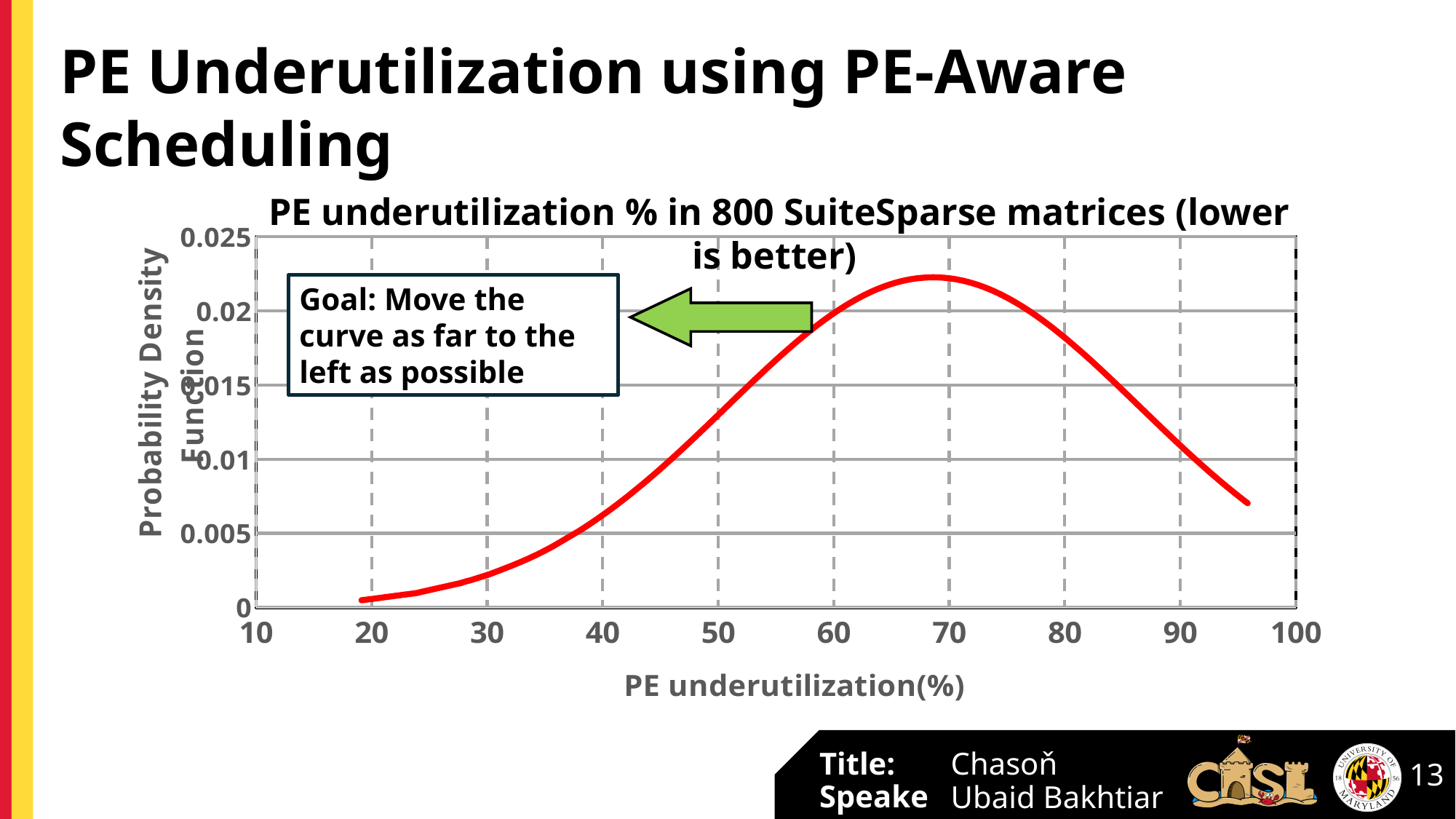
Between which two x-axis ticks does the curve reach its maximum? 60 and 70 Does the curve rise or fall between a PE underutilization of 70% and 90%? fall Is the value of the curve at a PE underutilization of 90% greater or less than 0.015? less Is the peak value of the curve greater or less than 0.02? greater Is the value of the curve at a PE underutilization of 30% greater or less than 0.005? less What is the label of the x axis of the chart? PE underutilization(%) Does the curve rise or fall between a PE underutilization of 20% and 60%? rise How many curves are plotted on the chart? 1 What kind of chart is shown on the slide? line chart What is the title of the chart? PE underutilization % in 800 SuiteSparse matrices (lower is better)